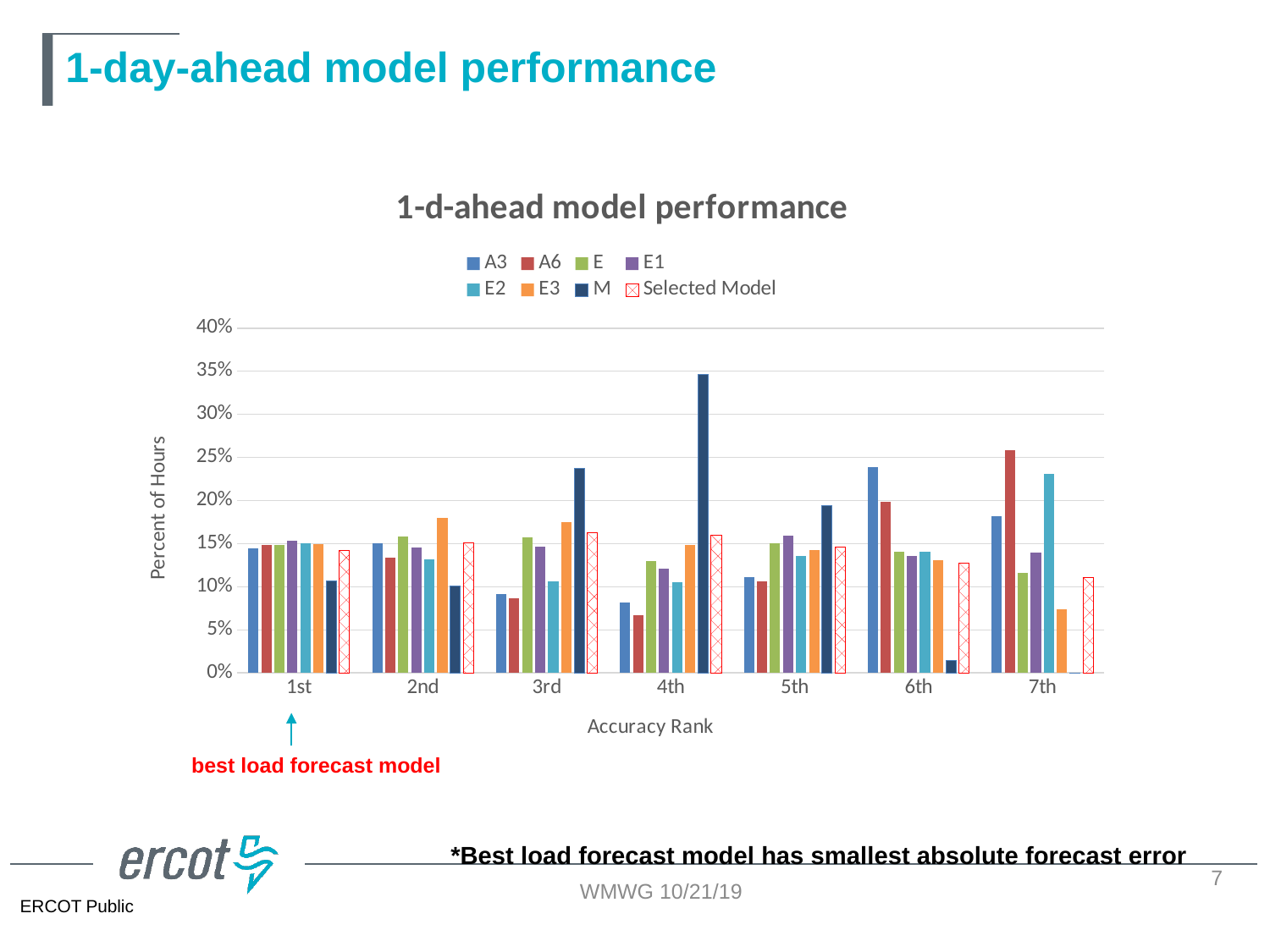
How many series does the legend list? 8 Which series has the highest value at the 7th accuracy rank? A6 Which series has the lowest value at the 1st accuracy rank? M At the 7th accuracy rank, which is larger, E2 or E3? E2 What kind of chart is shown on the slide? bar chart What is the label of the y axis? Percent of Hours Is the value for A3 at the 6th accuracy rank greater or less than 20%? greater Is the value for M at the 6th accuracy rank greater or less than 5%? less How many accuracy rank categories are shown on the x axis? 7 Which series has the highest value at the 4th accuracy rank? M At which accuracy rank is the M series highest? 4th Is the value for M at the 4th accuracy rank greater or less than 30%? greater